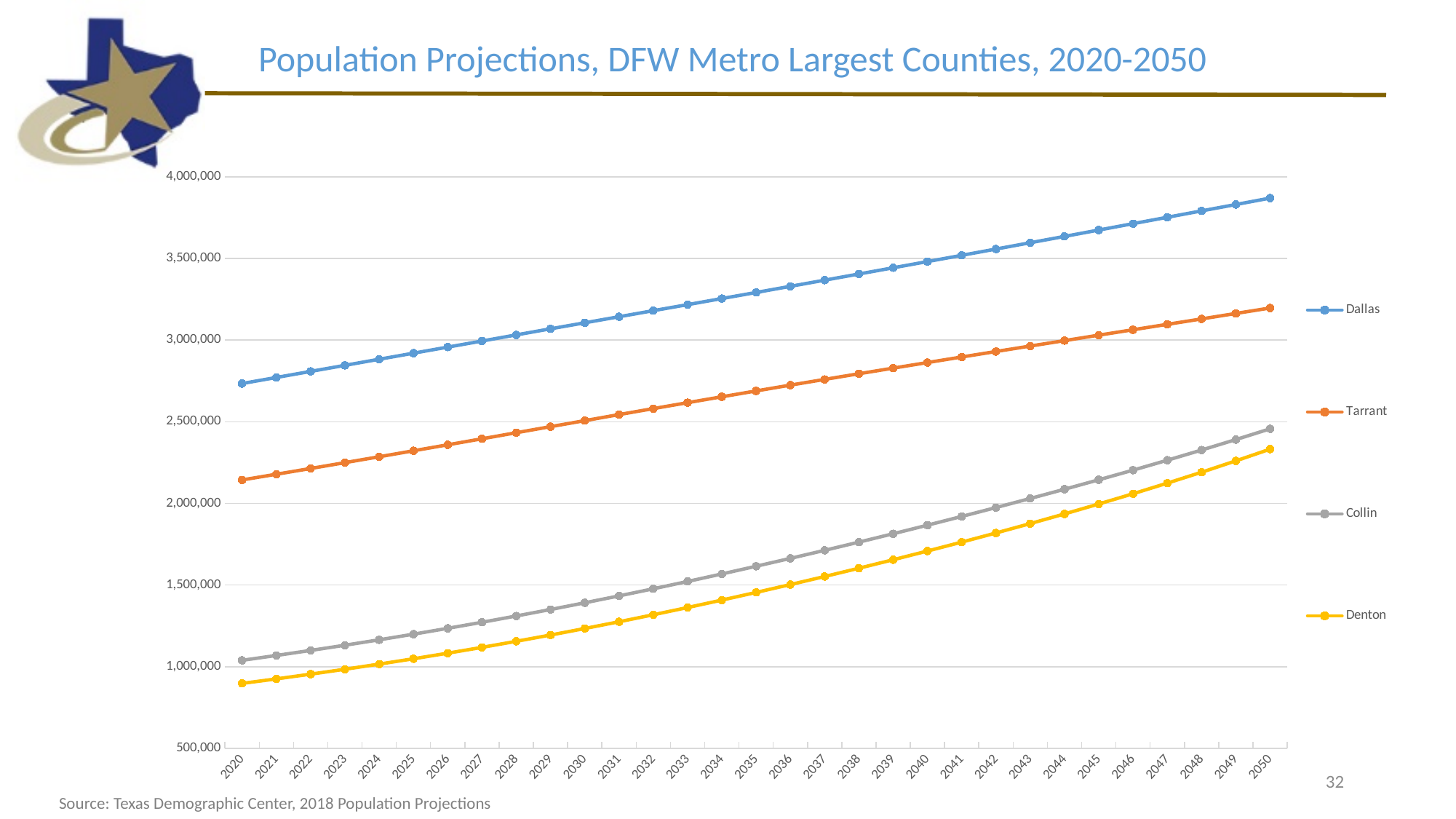
How many years are plotted along the x axis? 31 How many series does the legend list? 4 Which county has the highest projected population in 2050? Dallas Do the projected populations rise or fall from 2020 to 2050? Rise What kind of chart is shown on the slide? Line chart Is the value for Dallas in 2050 greater or less than 4,000,000? less Is the value for Dallas in 2020 greater or less than 2,500,000? greater Which county has the lowest projected population in 2020? Denton Is the value for Denton in 2020 greater or less than 1,000,000? less What is the title of the chart? Population Projections, DFW Metro Largest Counties, 2020-2050 In 2030, which is larger, the value for Collin or the value for Denton? Collin